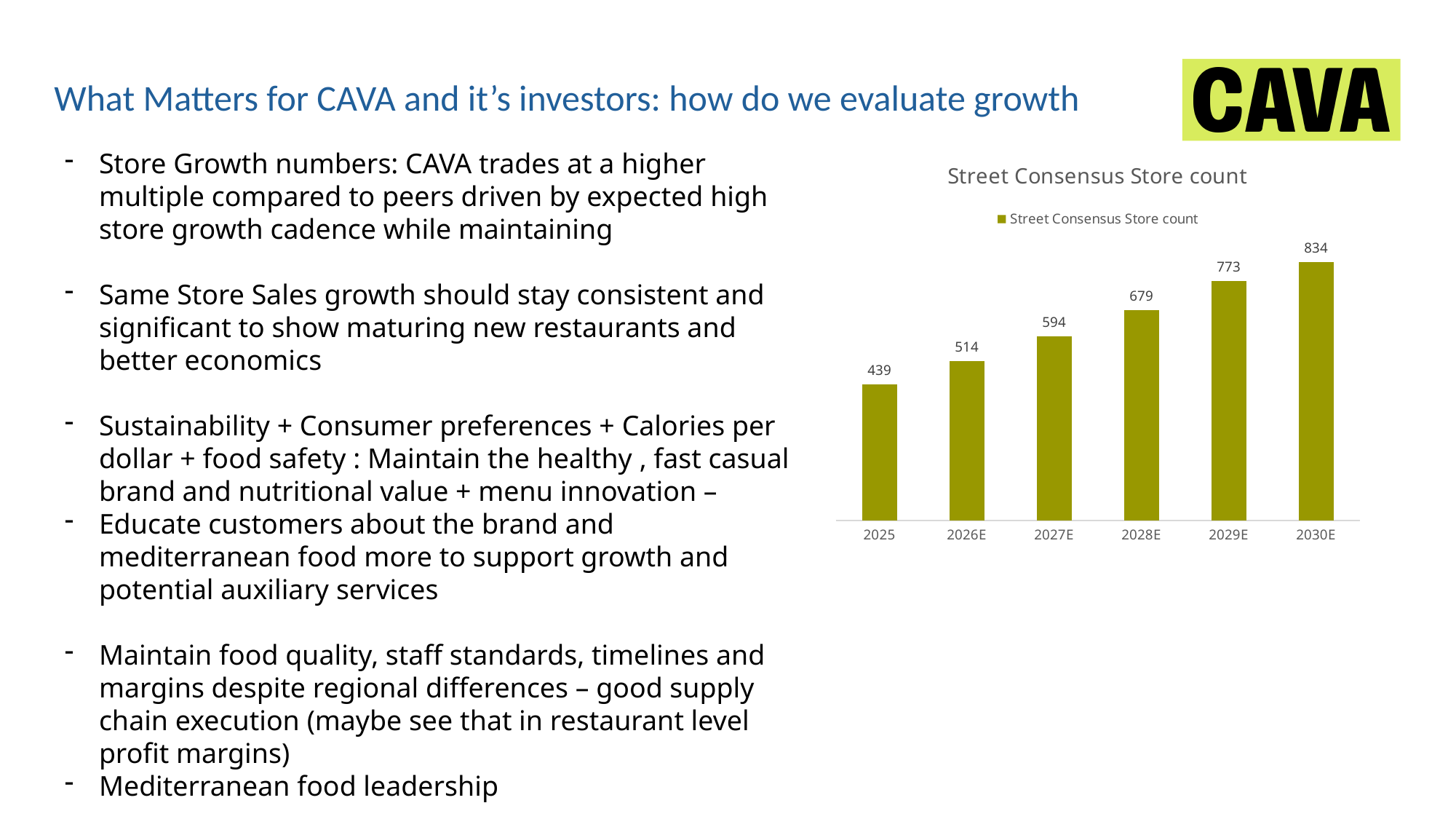
What is the Street Consensus Store count for 2028E? 679 What kind of chart is shown on the slide? Bar chart Which year has the lowest Street Consensus Store count? 2025 Which is larger, the store count for 2029E or for 2027E? 2029E Which year has the highest Street Consensus Store count? 2030E What is the difference in store count between 2030E and 2025? 395 How many years are shown on the x axis of the chart? 6 What is the Street Consensus Store count for 2025? 439 What is the difference in store count between 2027E and 2026E? 80 Does the Street Consensus Store count rise or fall from 2025 to 2030E? Rise How many series does the chart legend list? 1 What is the Street Consensus Store count for 2030E? 834